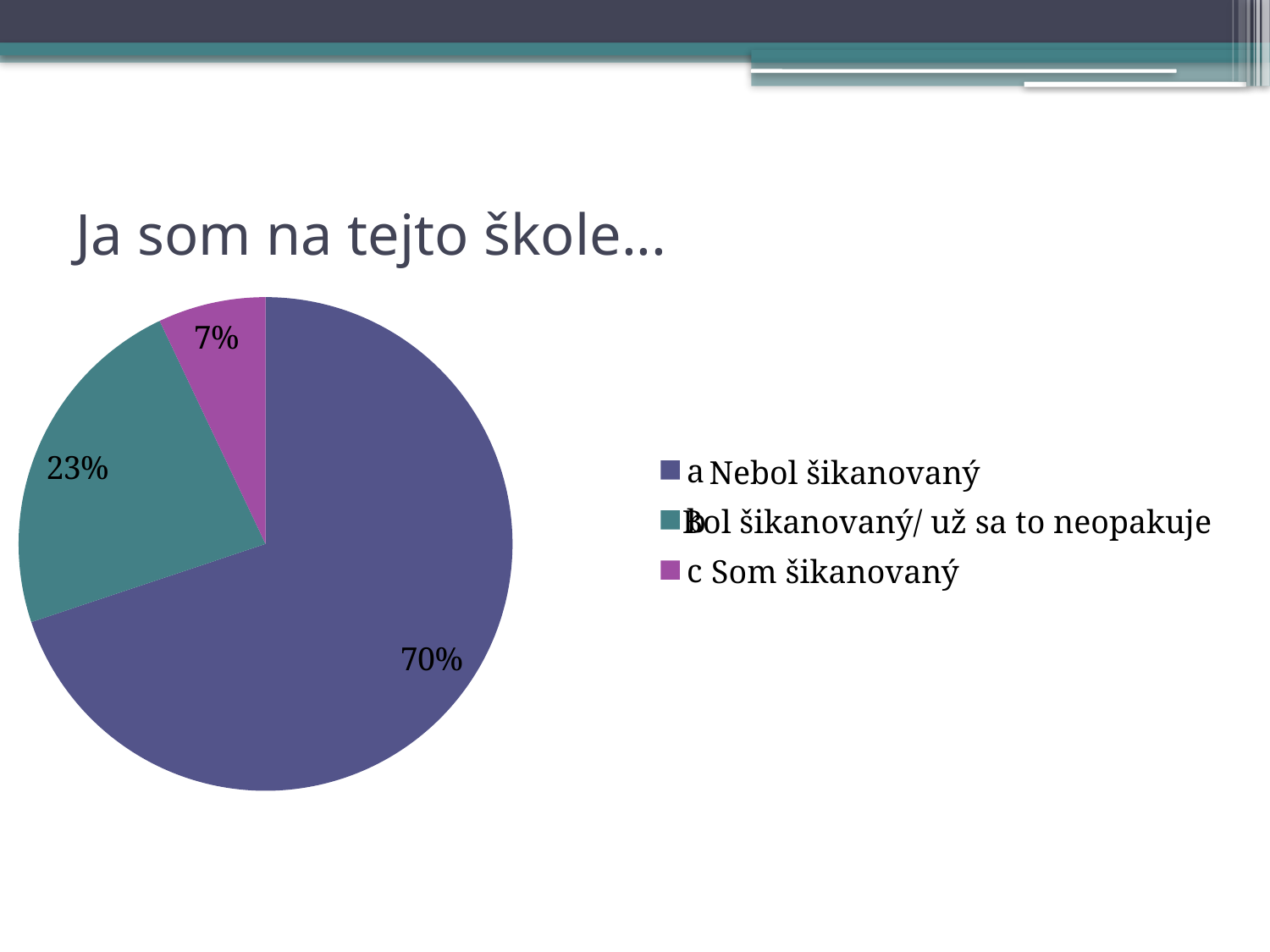
What is the value shown for the slice "Bol šikanovaný/ už sa to neopakuje"? 23% What colour is the slice for "c Som šikanovaný"? purple Which category has the smallest slice of the pie? c Som šikanovaný Which category has the largest slice of the pie? a Nebol šikanovaný What share of the pie does "a Nebol šikanovaný" take? 70% What kind of chart is shown on the slide? pie chart What share of the pie does "c Som šikanovaný" take? 7% How many entries does the legend list? 3 How many slices does the pie chart have? 3 What is the difference in percentage points between the "a Nebol šikanovaný" slice and the "c Som šikanovaný" slice? 63 What is the title of the slide above the chart? Ja som na tejto škole… Which is larger: the slice for "Bol šikanovaný/ už sa to neopakuje" or the slice for "c Som šikanovaný"? Bol šikanovaný/ už sa to neopakuje